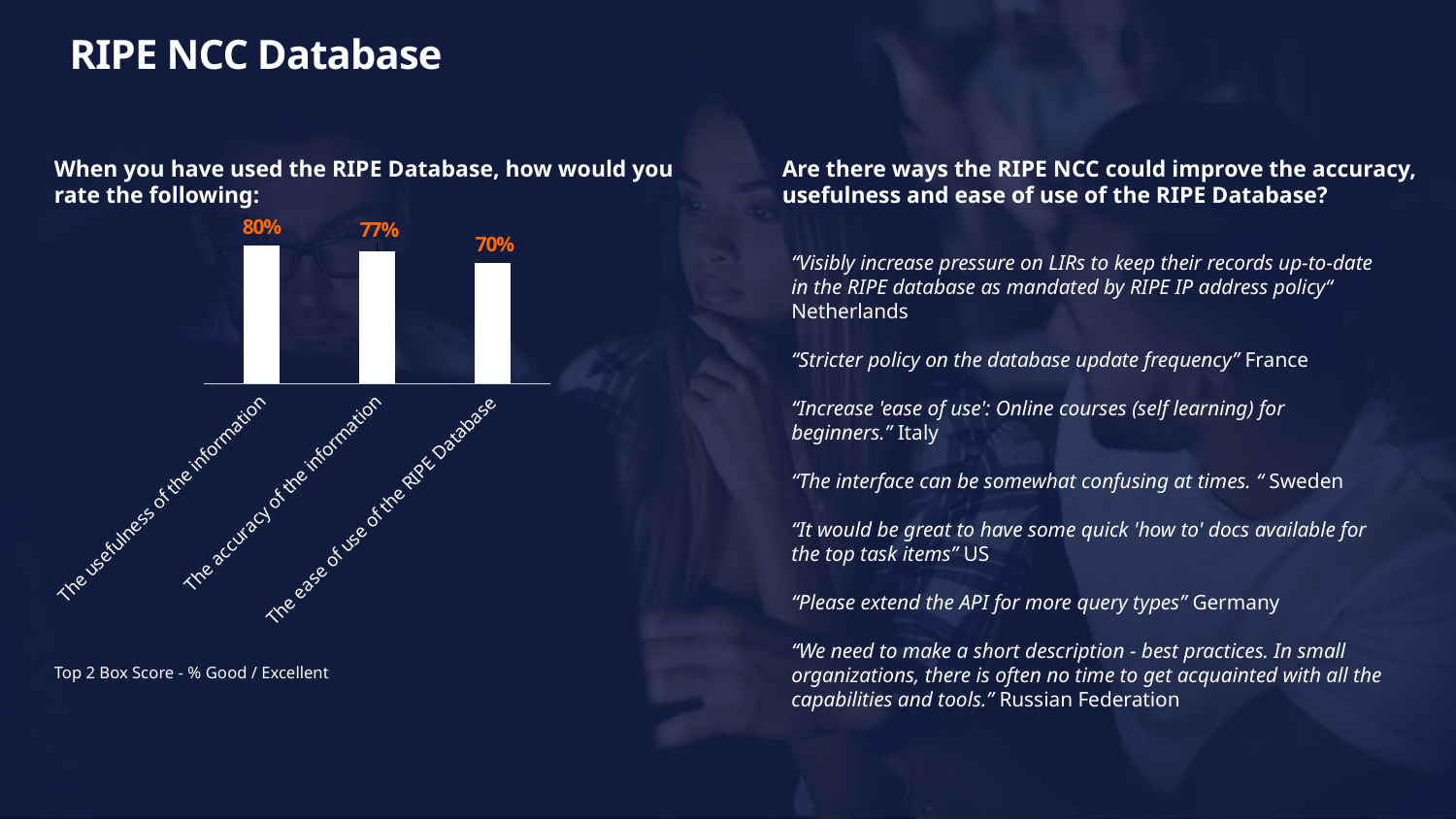
How many categories are shown in the chart? 3 What kind of chart is shown on the slide? Bar chart Which category has the highest value? The usefulness of the information What does the note below the chart say the scores represent? Top 2 Box Score - % Good / Excellent What is the difference between the values for 'The usefulness of the information' and 'The accuracy of the information'? 3% Do the values rise or fall from left to right along the x axis? Fall What is the value for 'The ease of use of the RIPE Database'? 70% Which category has the lowest value? The ease of use of the RIPE Database What is the value for 'The accuracy of the information'? 77% What is the difference between the values for 'The usefulness of the information' and 'The ease of use of the RIPE Database'? 10% Which is larger: the value for 'The accuracy of the information' or 'The ease of use of the RIPE Database'? The accuracy of the information What is the value for 'The usefulness of the information'? 80%